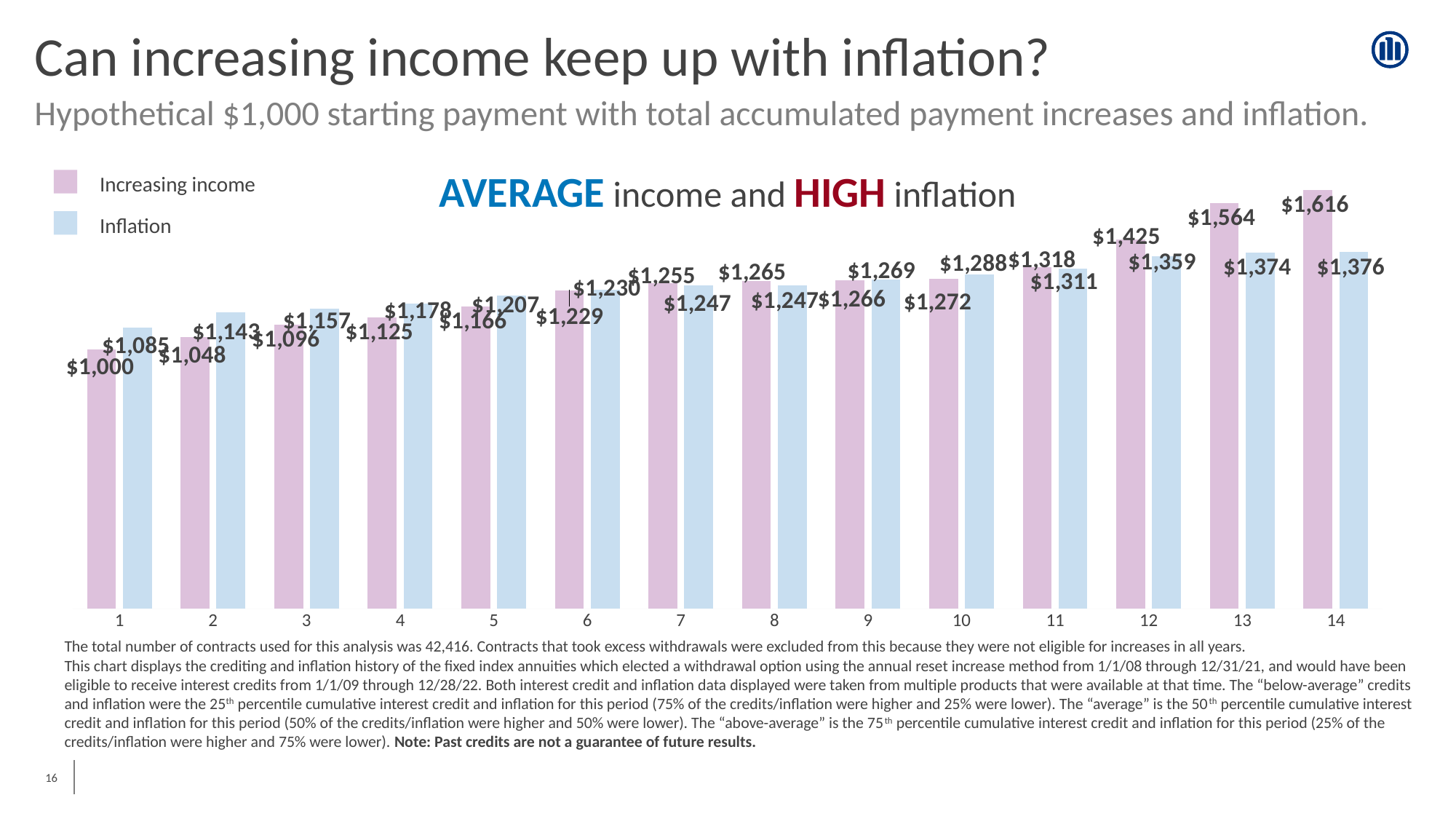
How many years are shown on the x axis? 14 Which year has the highest Increasing income value? 14 What is the Inflation value at year 14? $1,376 At year 13, which is larger: Increasing income or Inflation? Increasing income Which year has the lowest Inflation value? 1 At year 2, which is larger: Increasing income or Inflation? Inflation What is the difference between Increasing income and Inflation at year 14? $240 How many series does the legend list? 2 What is the Inflation value at year 1? $1,085 What kind of chart is shown on the slide? Bar chart What is the Increasing income value at year 12? $1,425 What is the Increasing income value at year 1? $1,000